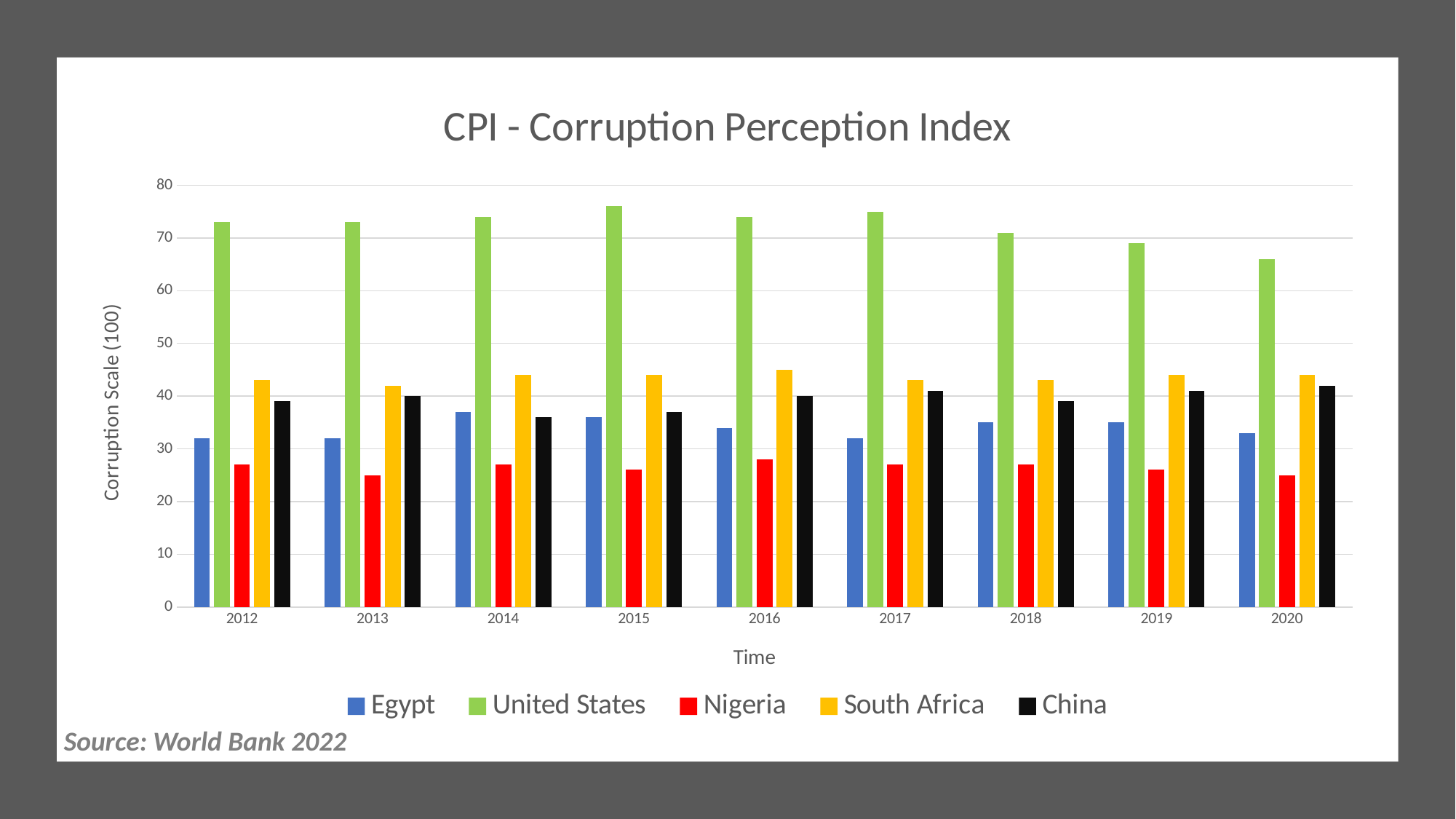
Which country has the highest CPI value in every year shown? United States Is the value for China in 2014 greater or less than 40? less Is the value for the United States in 2012 greater or less than 70? greater Is the value for the United States in 2020 greater or less than 70? less What kind of chart is shown on the slide? Bar chart What is the title of the vertical axis? Corruption Scale (100) Do the values for the United States rise or fall from 2017 to 2020? Fall Which country has the lowest CPI value in 2016? Nigeria How many series does the legend list? 5 How many years are shown along the x axis? 9 In 2012, which is larger: the value for Egypt or the value for Nigeria? Egypt